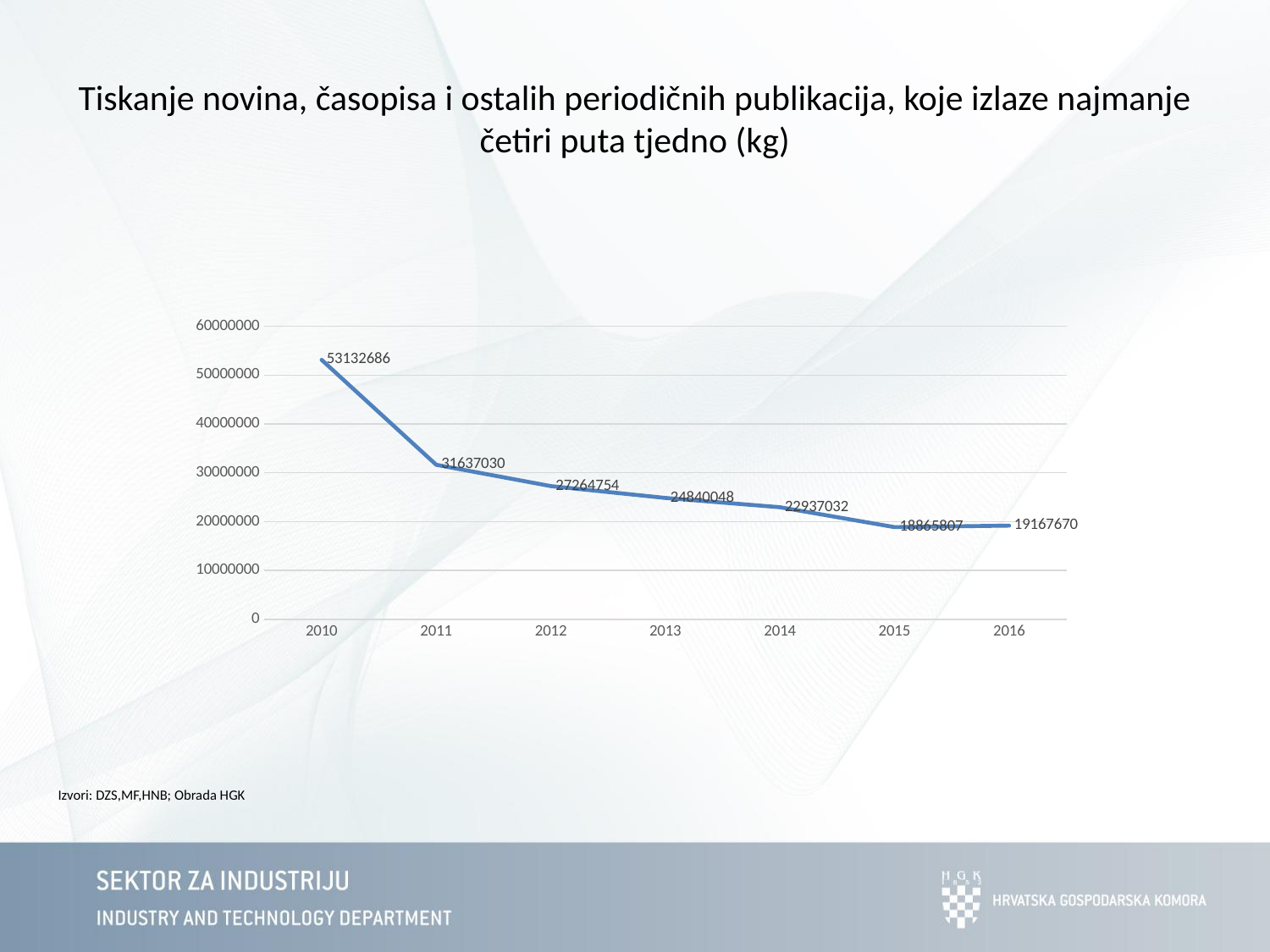
Do the values generally rise or fall from 2010 to 2016? fall Which year has the lowest value? 2015 What is the difference between the values for 2016 and 2015? 301863 What is the value for 2016? 19167670 What kind of chart is shown on the slide? line chart Which is larger, the value for 2012 or the value for 2014? 2012 What is the value for 2013? 24840048 Which year has the highest value? 2010 Is the value for 2011 greater or less than 30000000? greater How many years are plotted on the chart? 7 What is the value for 2010? 53132686 What is the difference between the values for 2010 and 2011? 21495656